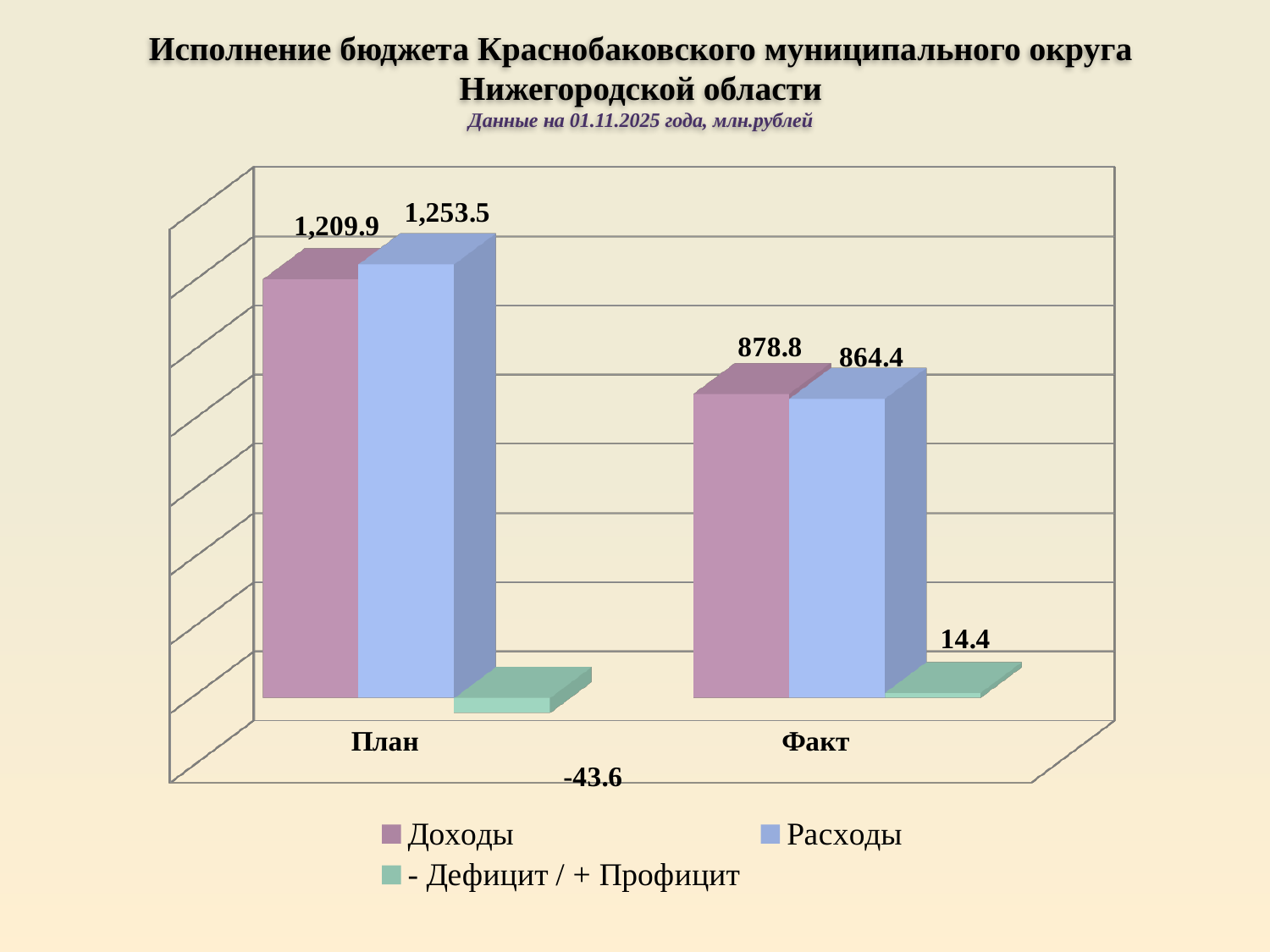
What is the difference between Доходы for План and Доходы for Факт? 331.1 What is the value of the - Дефицит / + Профицит series for План? -43.6 Which is larger for План: Доходы or Расходы? Расходы What is the difference between Расходы and Доходы for План? 43.6 What is the value of the - Дефицит / + Профицит series for Факт? 14.4 How many series does the legend list? 3 What is the value of Доходы for План? 1,209.9 What kind of chart is shown on the slide? Bar chart Which is larger for Факт: Доходы or Расходы? Доходы What is the value of Доходы for Факт? 878.8 What is the value of Расходы for Факт? 864.4 What is the value of Расходы for План? 1,253.5